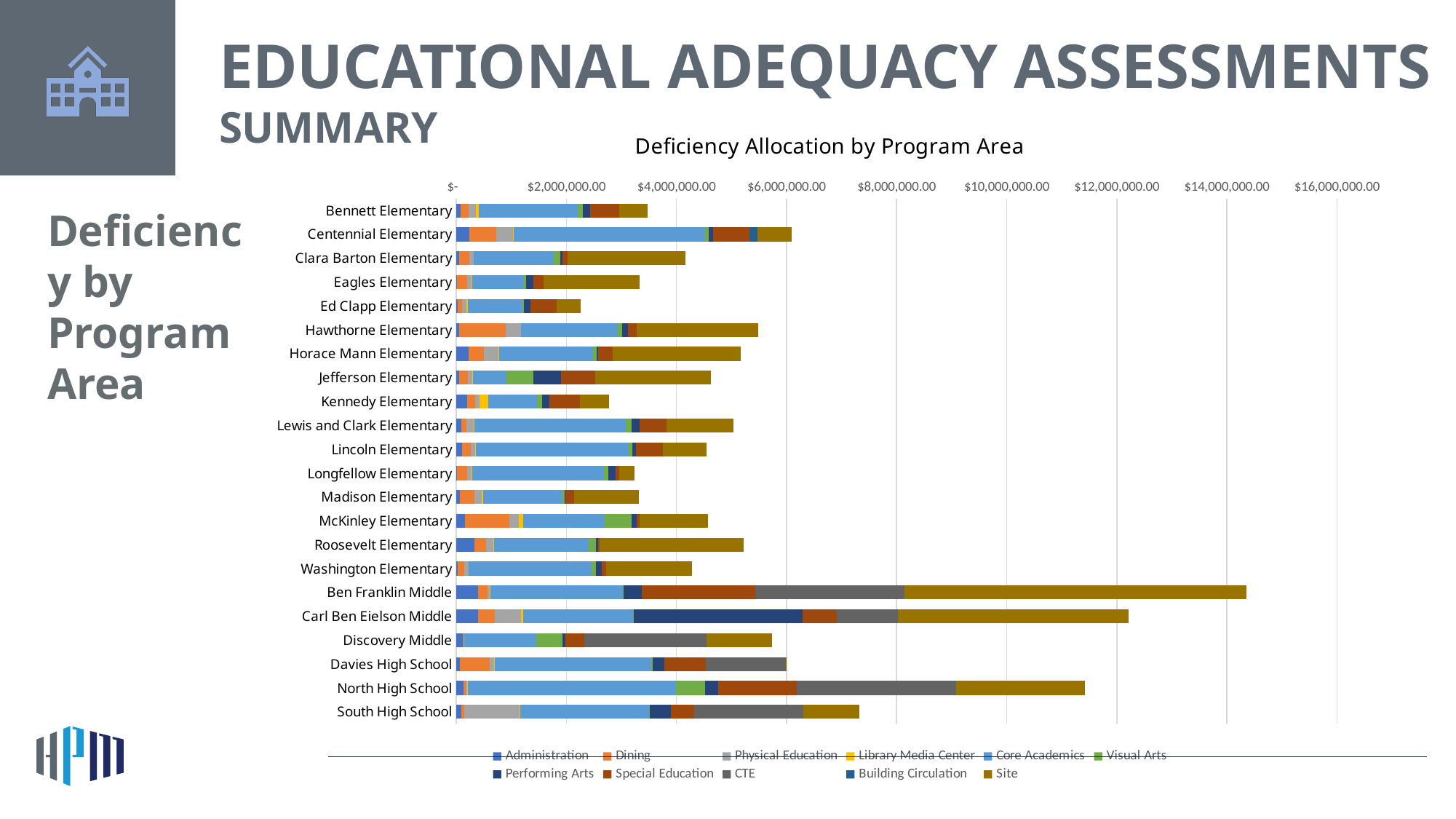
How many series does the chart legend list? 11 Which school has the smallest total deficiency allocation? Ed Clapp Elementary What is the title of the chart? Deficiency Allocation by Program Area Which has the larger total deficiency allocation, Ben Franklin Middle or Carl Ben Eielson Middle? Ben Franklin Middle Which school has the largest total deficiency allocation? Ben Franklin Middle Is the total deficiency allocation for Discovery Middle greater or less than $6,000,000.00? less Is the total deficiency allocation for North High School greater or less than $10,000,000.00? greater Which has the larger total deficiency allocation, Hawthorne Elementary or Kennedy Elementary? Hawthorne Elementary What type of chart is shown on the slide? Stacked bar chart Is the total deficiency allocation for Ed Clapp Elementary greater or less than $4,000,000.00? less How many schools are plotted on the chart? 22